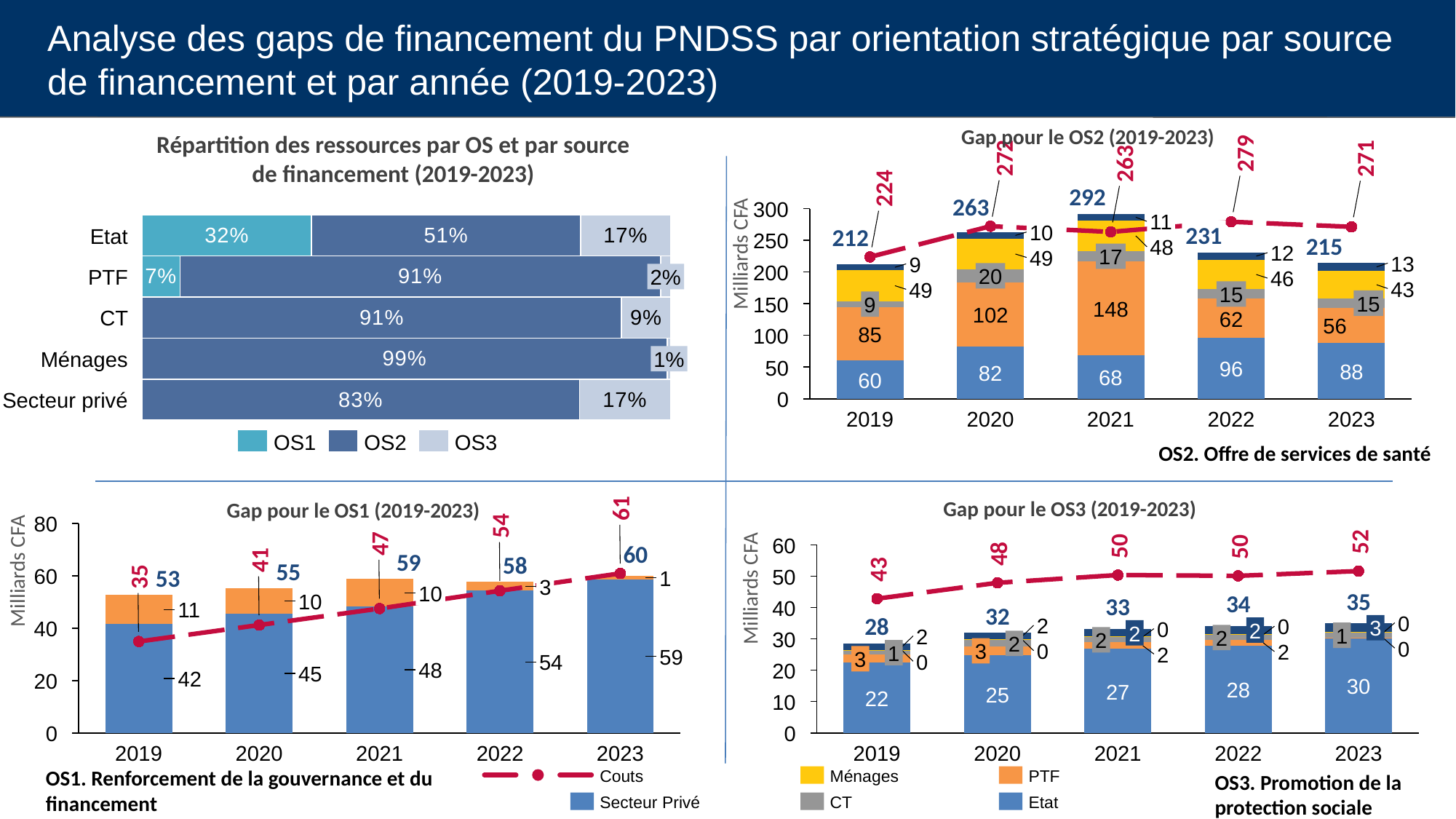
In the chart 'Gap pour le OS2 (2019-2023)', what is the total of the stacked bar for 2021? 292 In the chart 'Gap pour le OS2 (2019-2023)', what is the Couts value for 2022? 279 In the chart 'Répartition des ressources par OS et par source de financement (2019-2023)', what share of Etat resources goes to OS2? 51% In the chart 'Gap pour le OS1 (2019-2023)', do the Couts values rise or fall from 2019 to 2023? rise In the chart 'Gap pour le OS3 (2019-2023)', what is the Etat value for 2021? 27 In the chart 'Répartition des ressources par OS et par source de financement (2019-2023)', which funding source has the highest share allocated to OS2? Ménages In the chart 'Gap pour le OS3 (2019-2023)', is the Couts value for 2019 greater or less than 40? greater How many series does the legend of the chart 'Répartition des ressources par OS et par source de financement (2019-2023)' list? 3 In the chart 'Gap pour le OS1 (2019-2023)', what is the Secteur Privé value for 2023? 59 In the chart 'Gap pour le OS2 (2019-2023)', what is the PTF value for 2020? 102 In the chart 'Gap pour le OS2 (2019-2023)', which year has the lowest stacked bar total? 2019 In the chart 'Gap pour le OS1 (2019-2023)', what is the difference between the Couts values for 2023 and 2019? 26